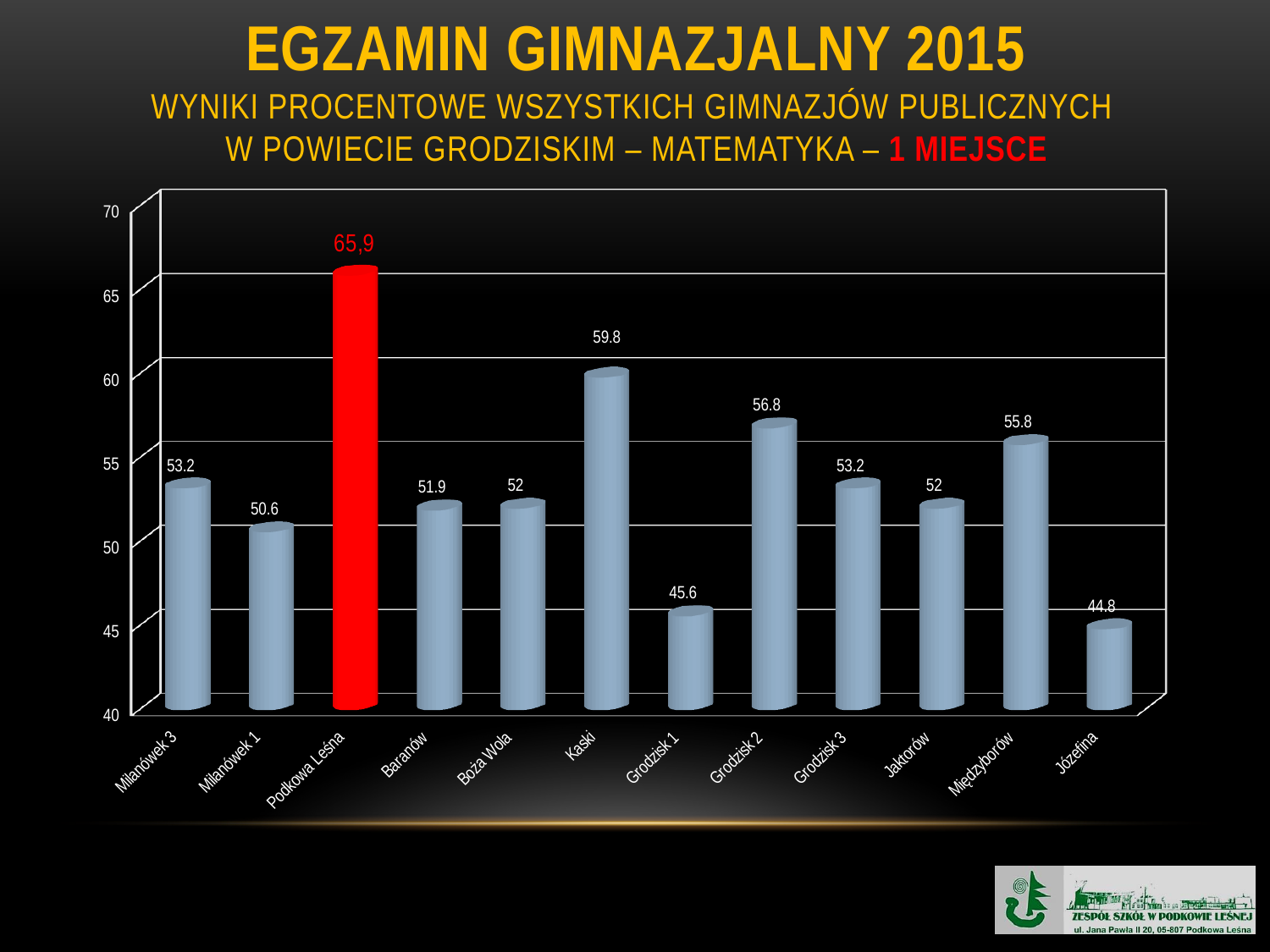
How many categories are shown on the x axis? 12 Which bar is coloured red? Podkowa Leśna What value is shown for Grodzisk 1? 45.6 What value is shown for Kaski? 59.8 What is the difference between the values for Milanówek 3 and Milanówek 1? 2.6 What is the difference between the values for Kaski and Grodzisk 2? 3 Which is larger, the value for Grodzisk 2 or the value for Międzyborów? Grodzisk 2 What value is shown for Międzyborów? 55.8 What kind of chart is shown on the slide? Bar chart Which category has the lowest value? Józefina Which category has the highest value? Podkowa Leśna What value is shown for Podkowa Leśna? 65,9